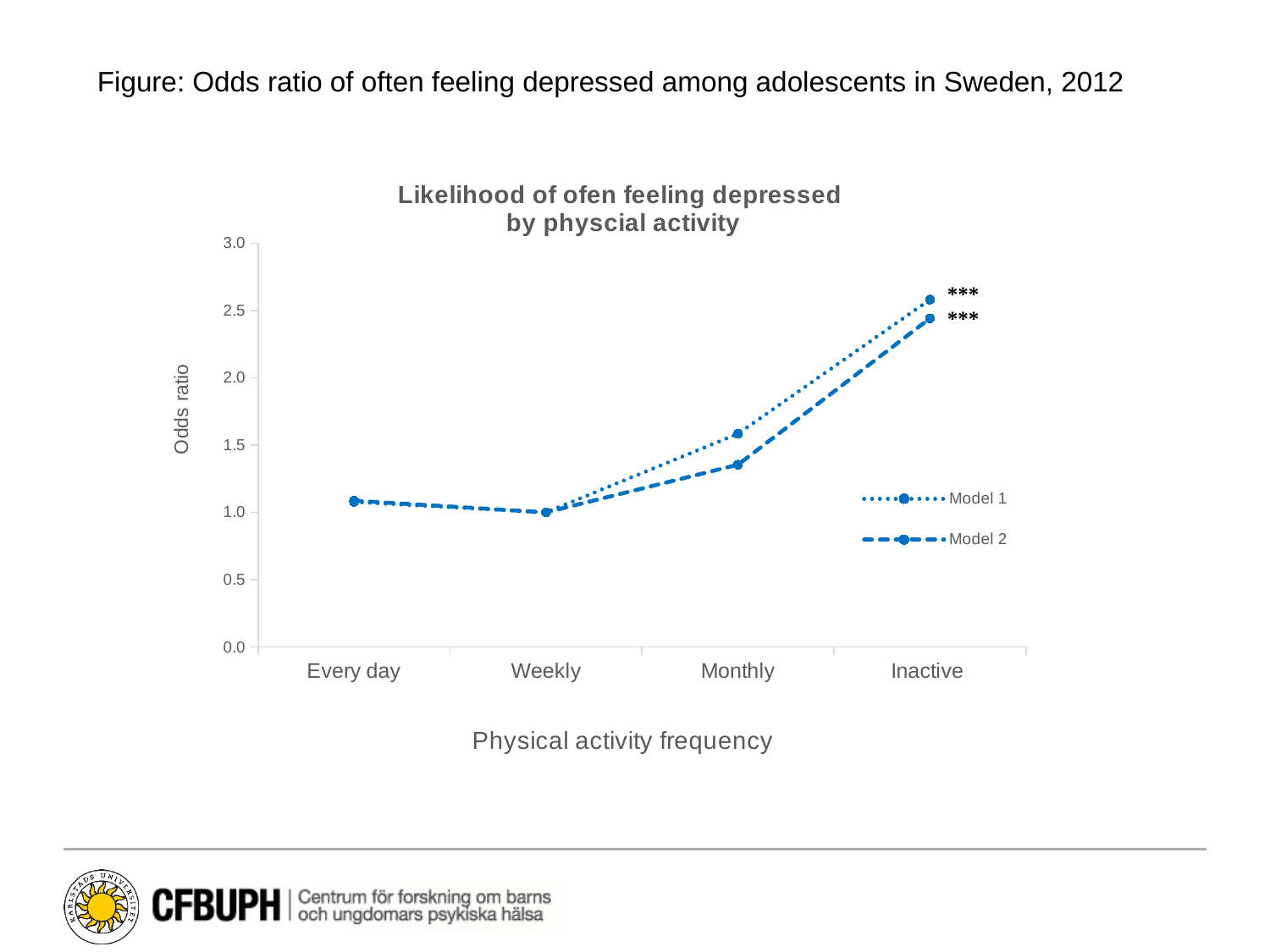
What is the label of the y axis? Odds ratio For the Monthly category, which model has the higher odds ratio, Model 1 or Model 2? Model 1 How many series does the legend list? 2 Is the Model 1 odds ratio for Monthly greater or less than 1.5? greater Is the Model 1 odds ratio for Inactive greater or less than 2.0? greater Do the odds ratios rise or fall from Weekly to Inactive along the x axis? rise What is the odds ratio for Weekly in Model 2? 1.0 What kind of chart is shown on the slide? line chart Is the Model 2 odds ratio for Monthly greater or less than 1.5? less Which physical activity category has the highest odds ratio for Model 1? Inactive Which physical activity category has the lowest odds ratio for Model 2? Weekly How many physical activity frequency categories are shown on the x axis? 4